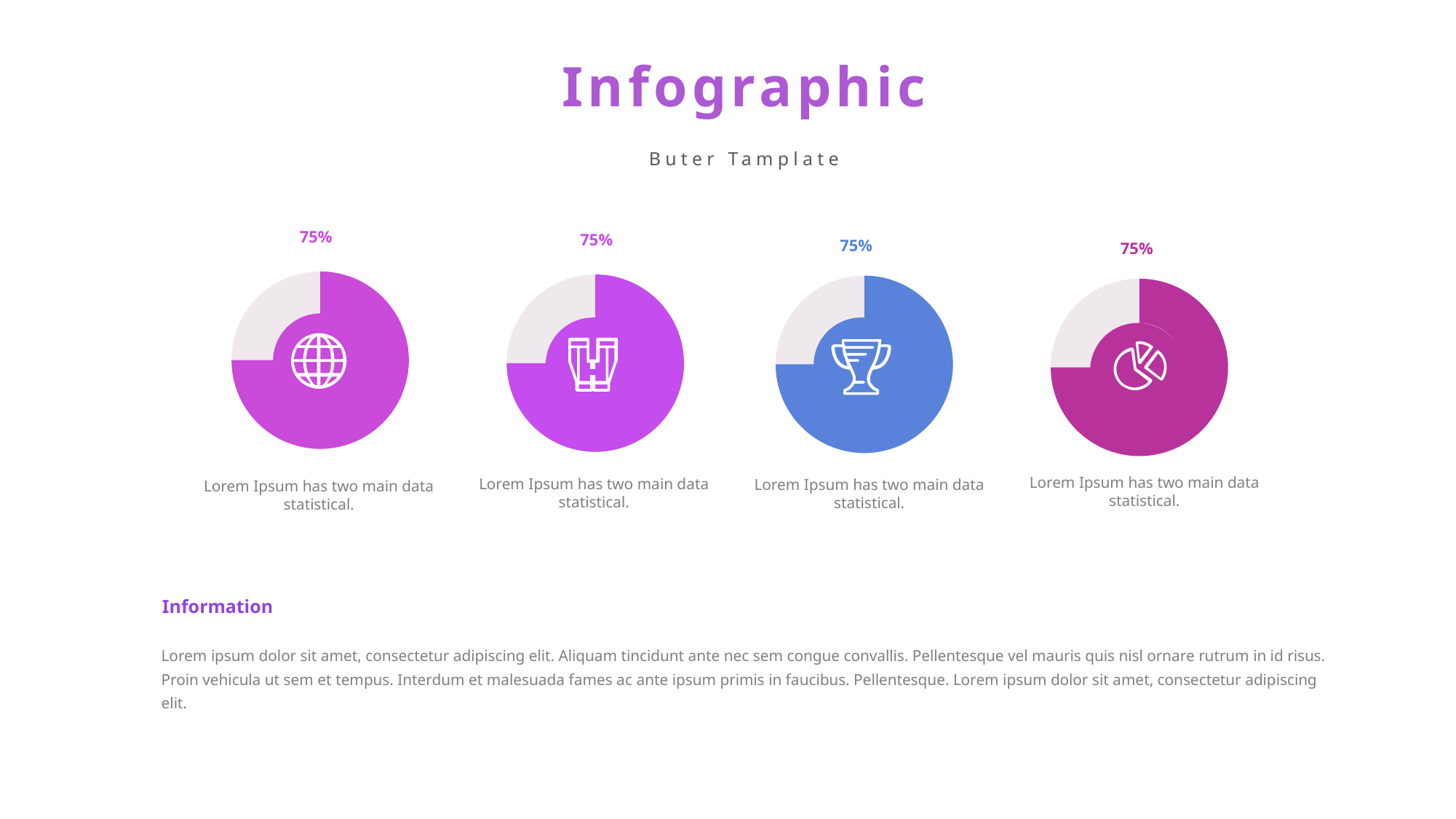
What colour is the filled slice of the third pie chart from the left? Blue What is the title of the slide containing the four pie charts? Infographic Is the value shown for the rightmost pie chart greater or less than 50%? greater What percentage is shown above the rightmost pie chart (with the pie-chart icon)? 75% What percentage is shown above the third pie chart from the left (with the trophy icon)? 75% What percentage is shown above the second pie chart from the left (with the binoculars icon)? 75% What kind of chart is used for each of the four graphics on the slide? Pie chart What percentage is shown above the leftmost pie chart (with the globe icon)? 75% In the third pie chart from the left, what share of the pie is filled with the blue slice? 75% In the leftmost pie chart, what share of the pie is filled with the coloured slice? 75% Do all four pie charts show the same percentage value? Yes How many pie charts are shown on the slide? 4